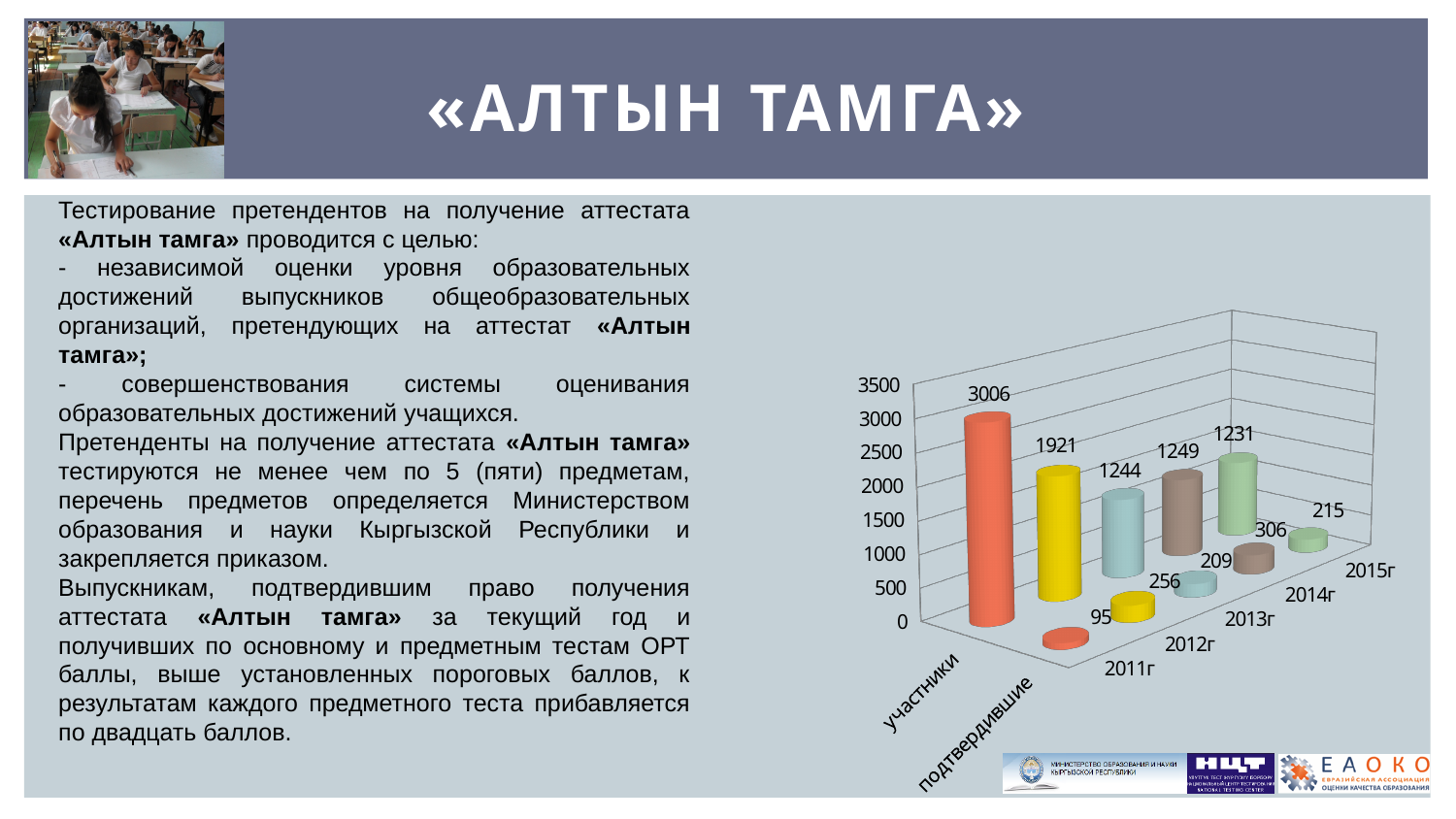
Which year has the lowest value for подтвердившие? 2011г How many years are shown on the chart? 5 What is the difference between участники in 2011г and участники in 2012г? 1085 What is the value for участники in 2013г? 1244 What is the value for подтвердившие in 2014г? 306 What is the difference between подтвердившие in 2014г and подтвердившие in 2015г? 91 Which year has the highest value for участники? 2011г Does the value for участники rise or fall from 2011г to 2013г? fall What kind of chart is shown on the slide? bar chart What is the value for подтвердившие in 2011г? 95 Which is larger: подтвердившие in 2012г or подтвердившие in 2013г? 2012г What is the value for участники in 2011г? 3006